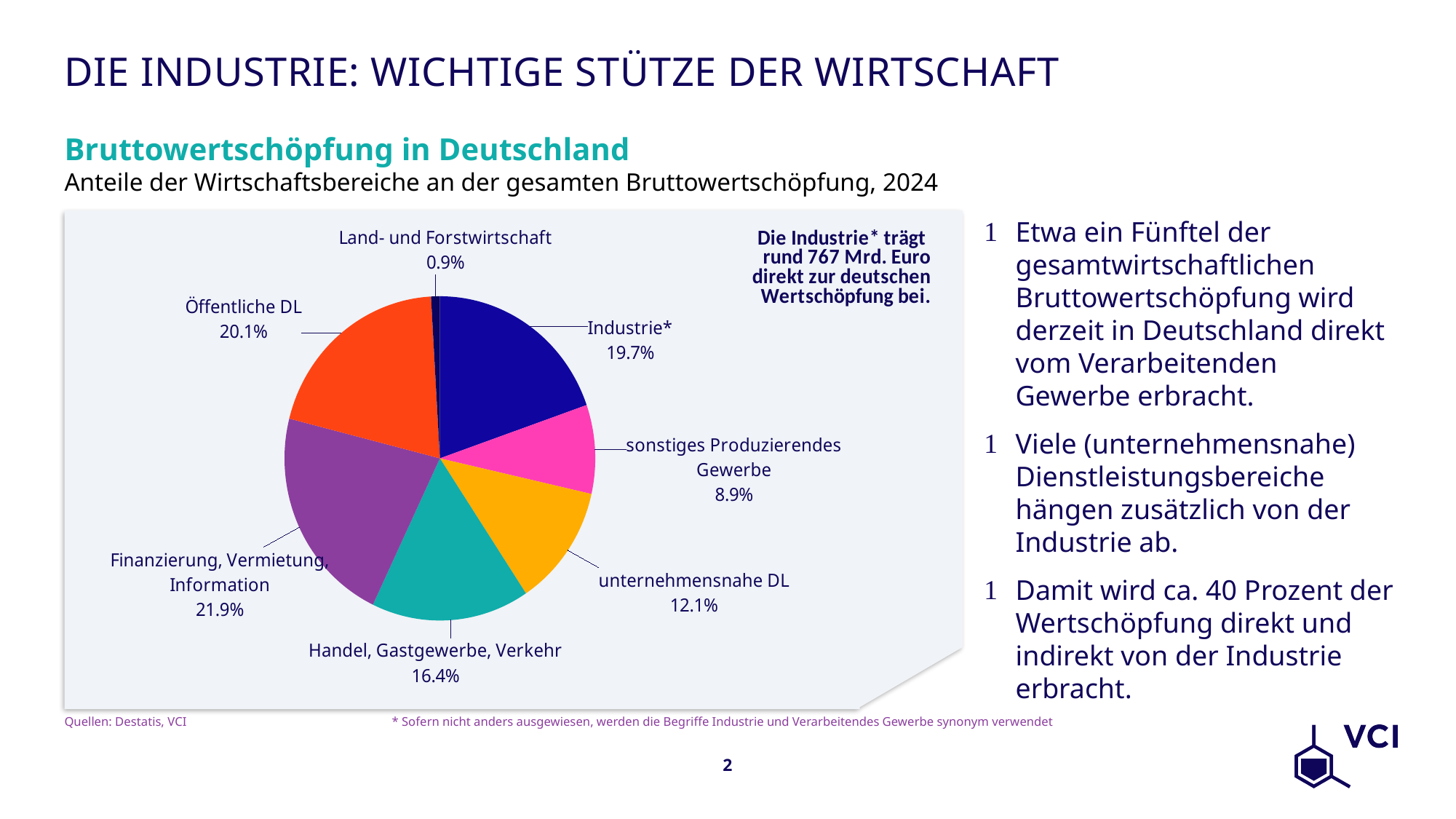
What share of gross value added does Industrie* account for in the pie chart? 19.7% What is the title of the chart? Bruttowertschöpfung in Deutschland What is the share shown for Öffentliche DL? 20.1% Which sector has the largest share in the pie chart? Finanzierung, Vermietung, Information What kind of chart is shown on the slide? pie chart Which is larger: the share of Handel, Gastgewerbe, Verkehr or the share of unternehmensnahe DL? Handel, Gastgewerbe, Verkehr What is the share shown for unternehmensnahe DL? 12.1% What is the share shown for Handel, Gastgewerbe, Verkehr? 16.4% Which sector has the smallest share in the pie chart? Land- und Forstwirtschaft What is the difference in percentage points between Industrie* and sonstiges Produzierendes Gewerbe? 10.8 What is the difference in percentage points between Finanzierung, Vermietung, Information and Öffentliche DL? 1.8 How many slices does the pie chart have? 7